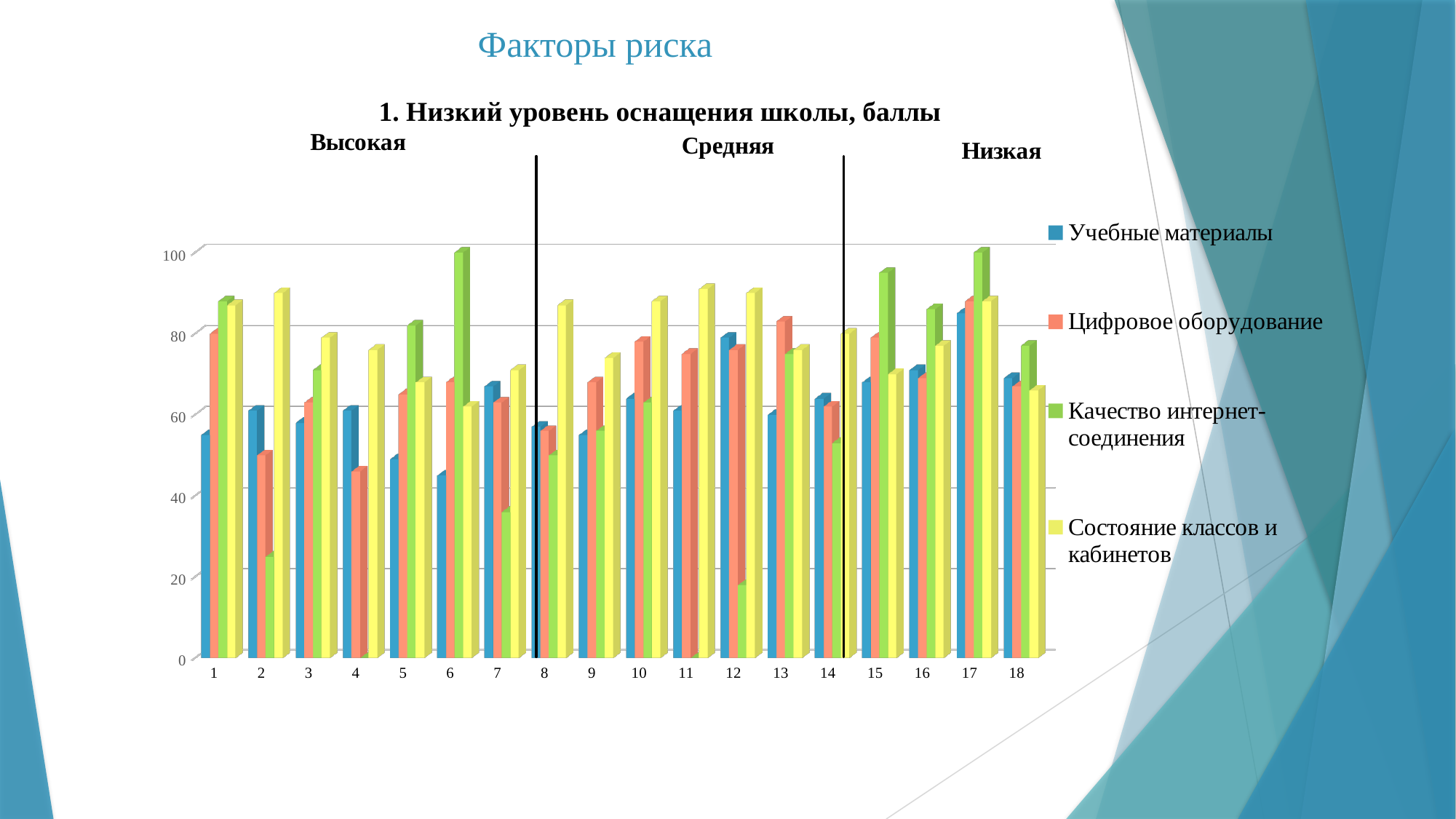
Is the value of Качество интернет-соединения for category 2 greater or less than 40? less Is the value of Учебные материалы for category 17 greater or less than 80? greater How many series does the chart legend list? 4 Is the value of Качество интернет-соединения for category 6 greater or less than 80? greater For category 6, which is larger: Учебные материалы or Качество интернет-соединения? Качество интернет-соединения How many categories are shown along the x axis of the chart? 18 What kind of chart is shown on the slide? Bar chart What is the title of the chart? 1. Низкий уровень оснащения школы, баллы Which series is shown in green in the chart legend? Качество интернет-соединения Which is larger: Учебные материалы for category 1 or Учебные материалы for category 17? Category 17